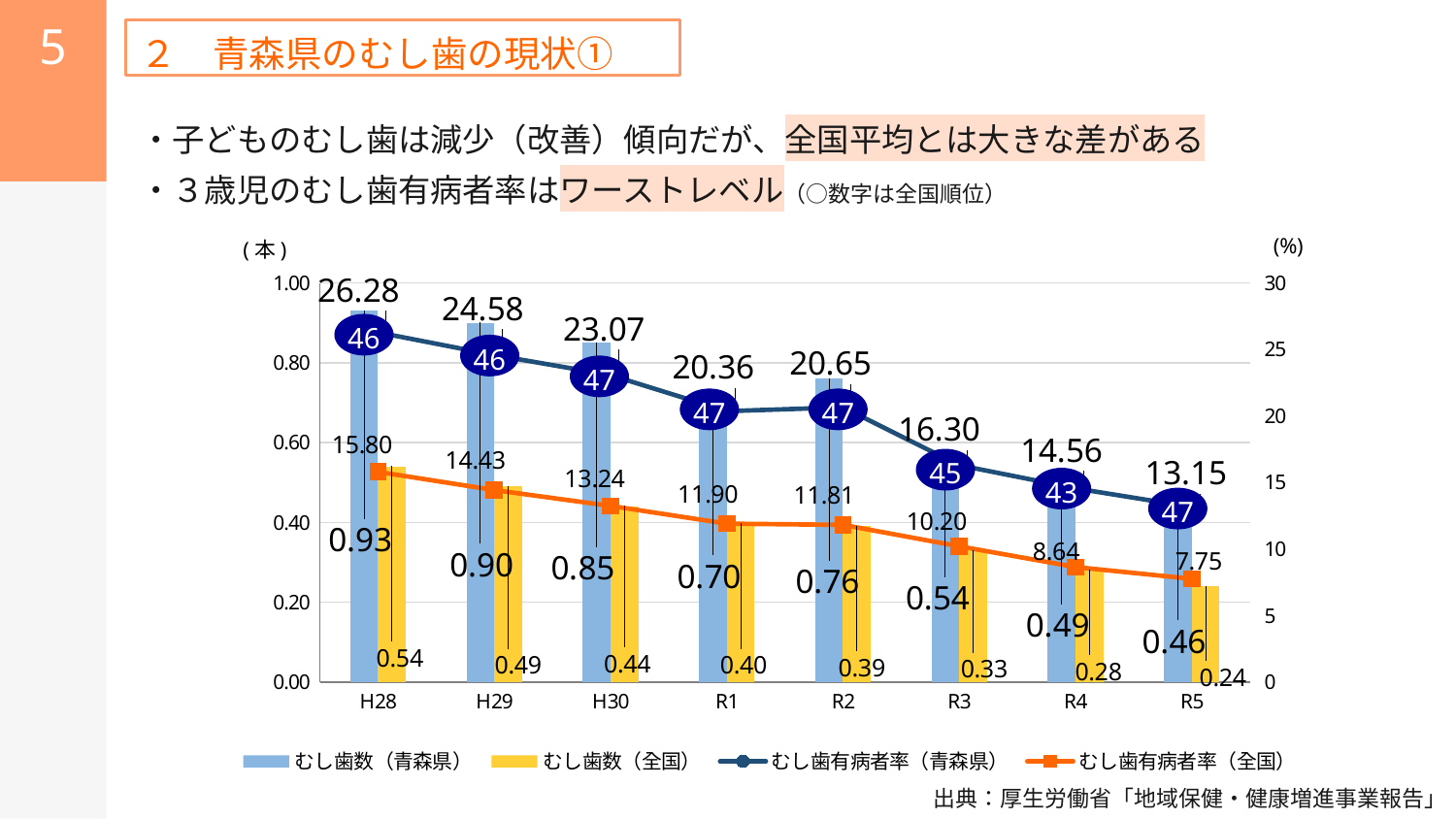
R1のむし歯有病者率について、青森県と全国の差はいくつですか？ 8.46 凡例にはいくつの系列が示されていますか？ 4 このグラフの出典はどこですか？ 厚生労働省「地域保健・健康増進事業報告」 R3のむし歯数は、青森県と全国のどちらが大きいですか？ 青森県 H28からR5にかけて、むし歯有病者率（青森県）は全体として上昇していますか、下降していますか？ 下降 むし歯有病者率（青森県）が最も高いのはどの年度ですか？ H28 このグラフには何年度分のデータがありますか？ 8 H28のむし歯数（青森県）の値はいくつですか？ 0.93 むし歯数（全国）が最も低いのはどの年度ですか？ R5 R4の青森県の全国順位（○数字）はいくつですか？ 43 R5のむし歯有病者率（全国）の値はいくつですか？ 7.75 R2のむし歯有病者率（青森県）の値はいくつですか？ 20.65